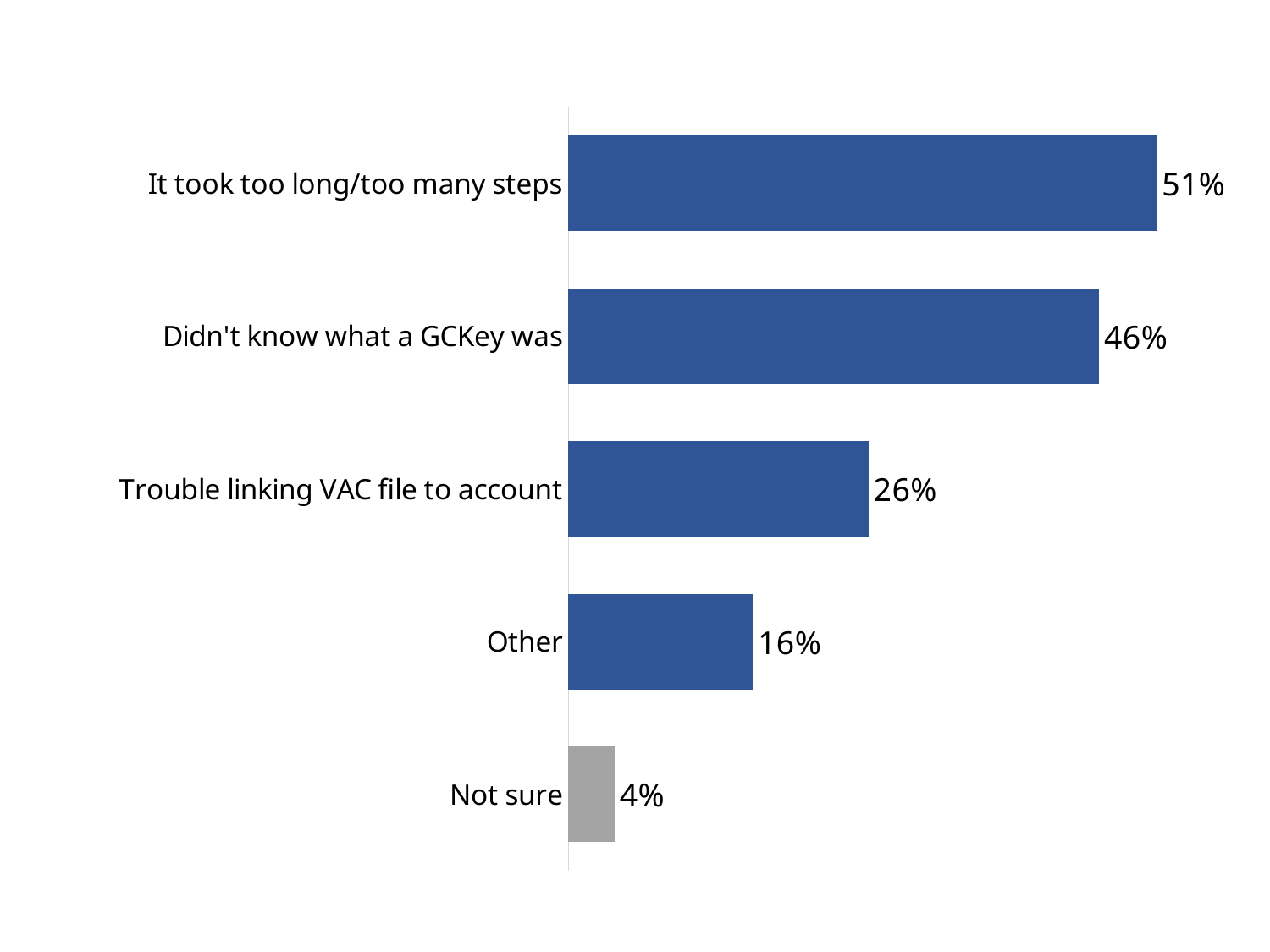
What is the value for "Other"? 16% What is the value for "Trouble linking VAC file to account"? 26% Which category has the lowest value? Not sure What is the difference between the values for "Trouble linking VAC file to account" and "Other"? 10% What is the value for "Not sure"? 4% What kind of chart is this? Bar chart Which category has the highest value? It took too long/too many steps How many categories are shown in the chart? 5 What is the difference between the values for "It took too long/too many steps" and "Didn't know what a GCKey was"? 5% What is the value for "It took too long/too many steps"? 51% Which is larger, the value for "Trouble linking VAC file to account" or the value for "Other"? Trouble linking VAC file to account What is the value for "Didn't know what a GCKey was"? 46%